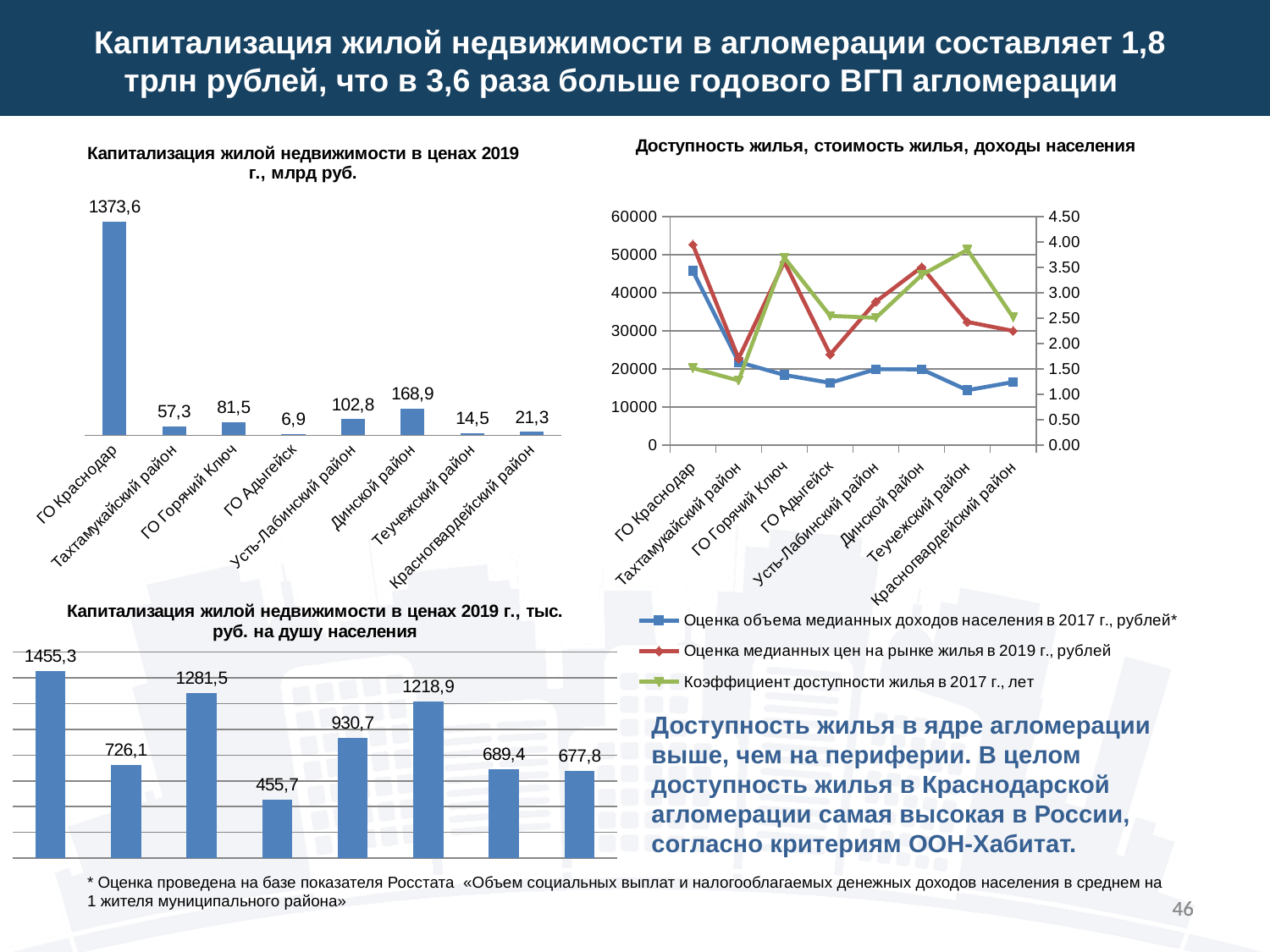
In the chart 'Капитализация жилой недвижимости в ценах 2019 г., тыс. руб. на душу населения', what is the lowest value shown? 455,7 In the chart 'Капитализация жилой недвижимости в ценах 2019 г., тыс. руб. на душу населения', what is the highest value shown? 1455,3 In the chart 'Капитализация жилой недвижимости в ценах 2019 г., млрд руб.', which is larger: ГО Горячий Ключ or Красногвардейский район? ГО Горячий Ключ In the chart 'Капитализация жилой недвижимости в ценах 2019 г., млрд руб.', what is the value for Динской район? 168,9 In the chart 'Доступность жилья, стоимость жилья, доходы населения', is the value of 'Коэффициент доступности жилья в 2017 г., лет' for Теучежский район greater or less than 3.50? greater What type of chart is 'Капитализация жилой недвижимости в ценах 2019 г., тыс. руб. на душу населения'? Bar chart In the chart 'Капитализация жилой недвижимости в ценах 2019 г., млрд руб.', what is the difference between Усть-Лабинский район and Тахтамукайский район? 45,5 In the chart 'Доступность жилья, стоимость жилья, доходы населения', is the value of 'Оценка объема медианных доходов населения в 2017 г., рублей*' for ГО Краснодар greater or less than 40000? greater How many categories are shown in the chart 'Капитализация жилой недвижимости в ценах 2019 г., млрд руб.'? 8 How many series does the legend list in the chart 'Доступность жилья, стоимость жилья, доходы населения'? 3 In the chart 'Капитализация жилой недвижимости в ценах 2019 г., млрд руб.', which category has the lowest value? ГО Адыгейск In the chart 'Капитализация жилой недвижимости в ценах 2019 г., млрд руб.', what is the value for ГО Краснодар? 1373,6